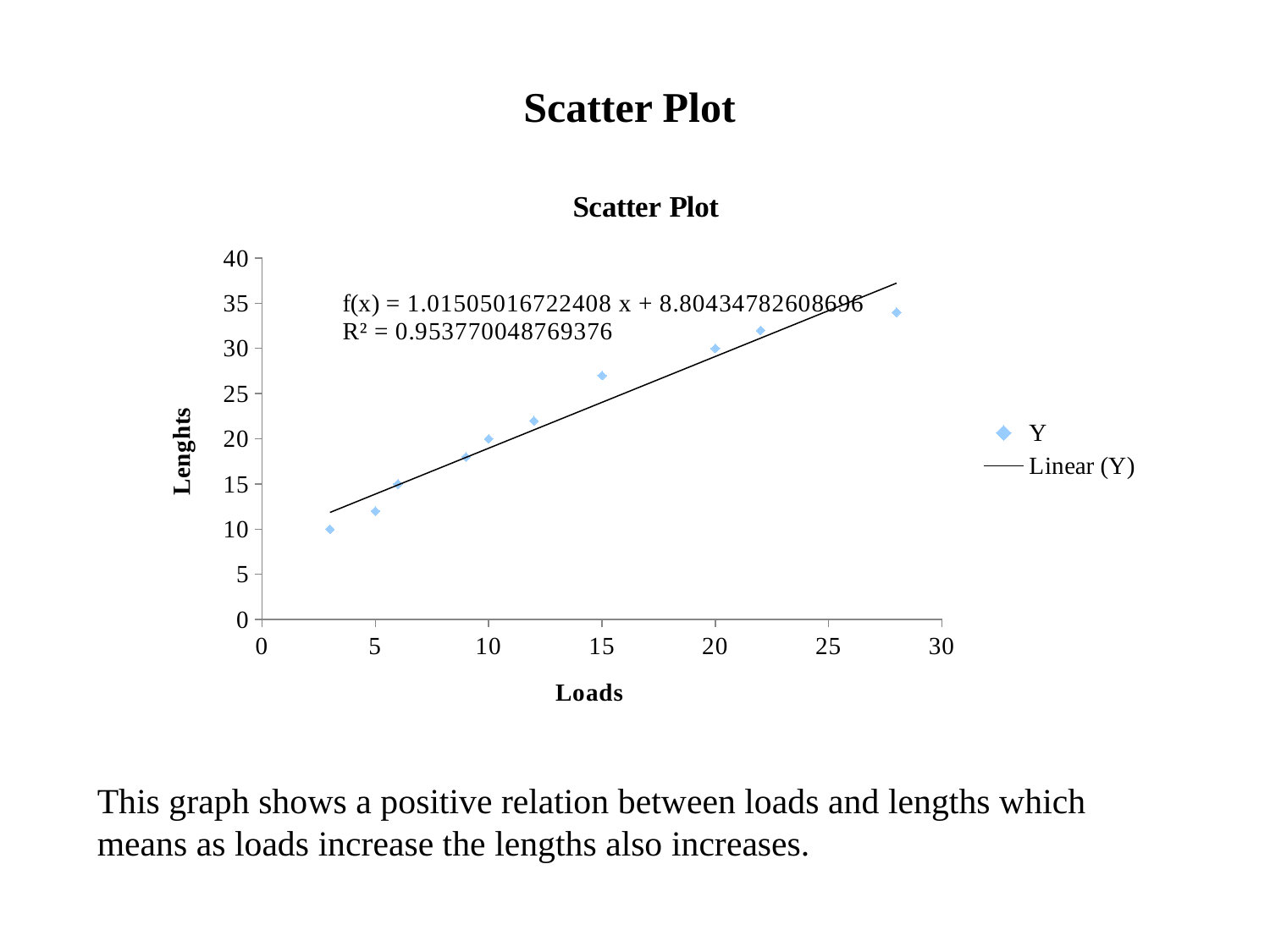
What kind of chart is shown on the slide? Scatter plot Is the length for the point at load 28 greater or less than 30? greater At which load does the highest length value occur? 28 Do the lengths rise or fall as the loads increase along the x axis? Rise What is the label of the x axis? Loads What is the length value for the point at load 10? 20 Is the length for the point at load 3 greater or less than 15? less What is the R² value printed on the chart? 0.953770048769376 At which load does the lowest length value occur? 3 What is the length value for the point at load 20? 30 How many data points are plotted in the scatter plot? 10 How many entries does the legend list? 2